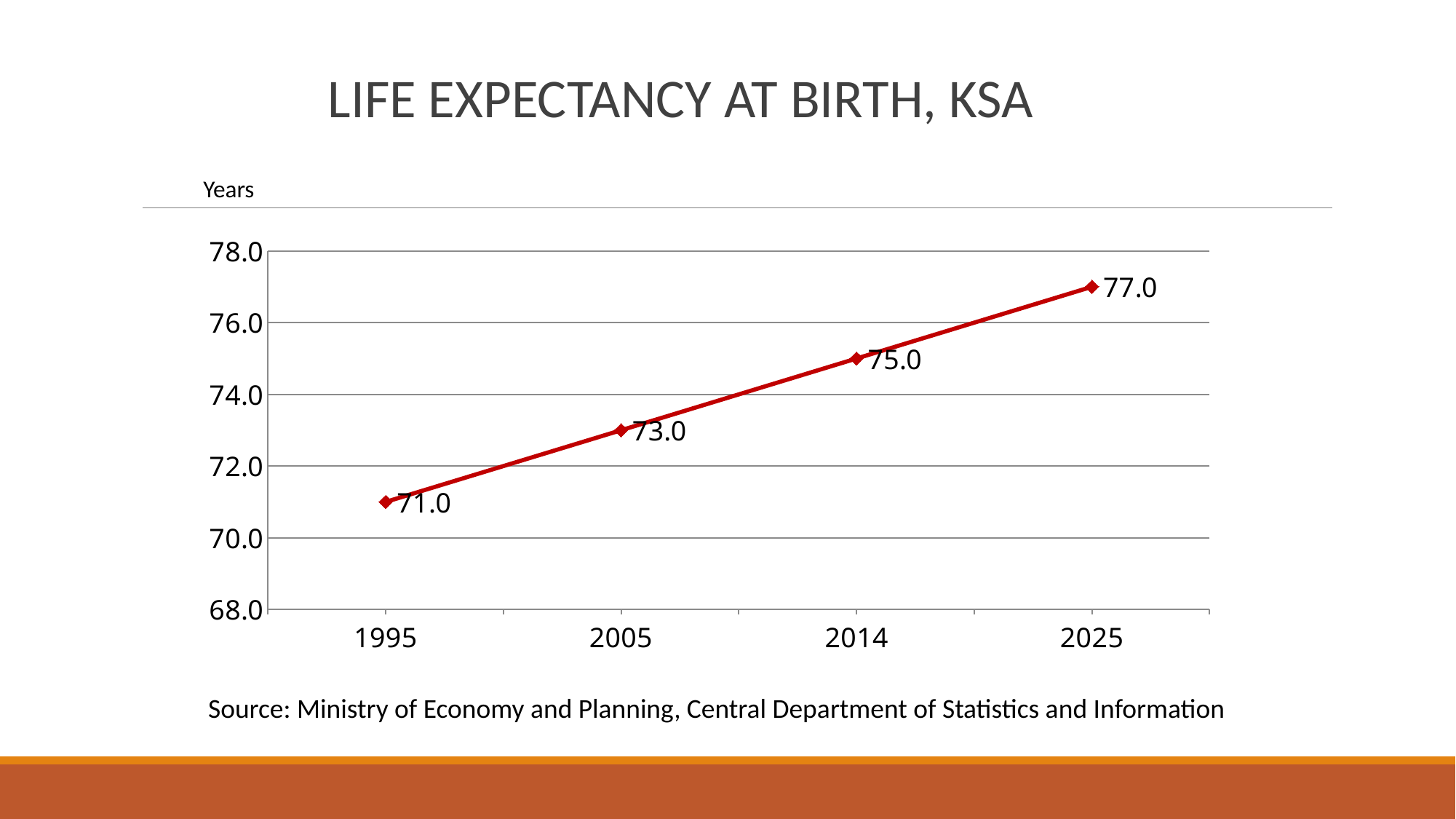
What is the life expectancy at birth for 2014? 75.0 Which year has the lowest life expectancy at birth? 1995 What is the life expectancy at birth for 2025? 77.0 What kind of chart is shown on the slide? Line chart What is the life expectancy at birth for 2005? 73.0 Which year has the highest life expectancy at birth? 2025 Which year has a higher life expectancy, 2005 or 2014? 2014 How many data points are plotted on the chart? 4 What is the life expectancy at birth for 1995? 71.0 What is the difference in life expectancy between 2014 and 2005? 2.0 What is the difference in life expectancy between 2025 and 1995? 6.0 Does life expectancy rise or fall from 1995 to 2025? Rise